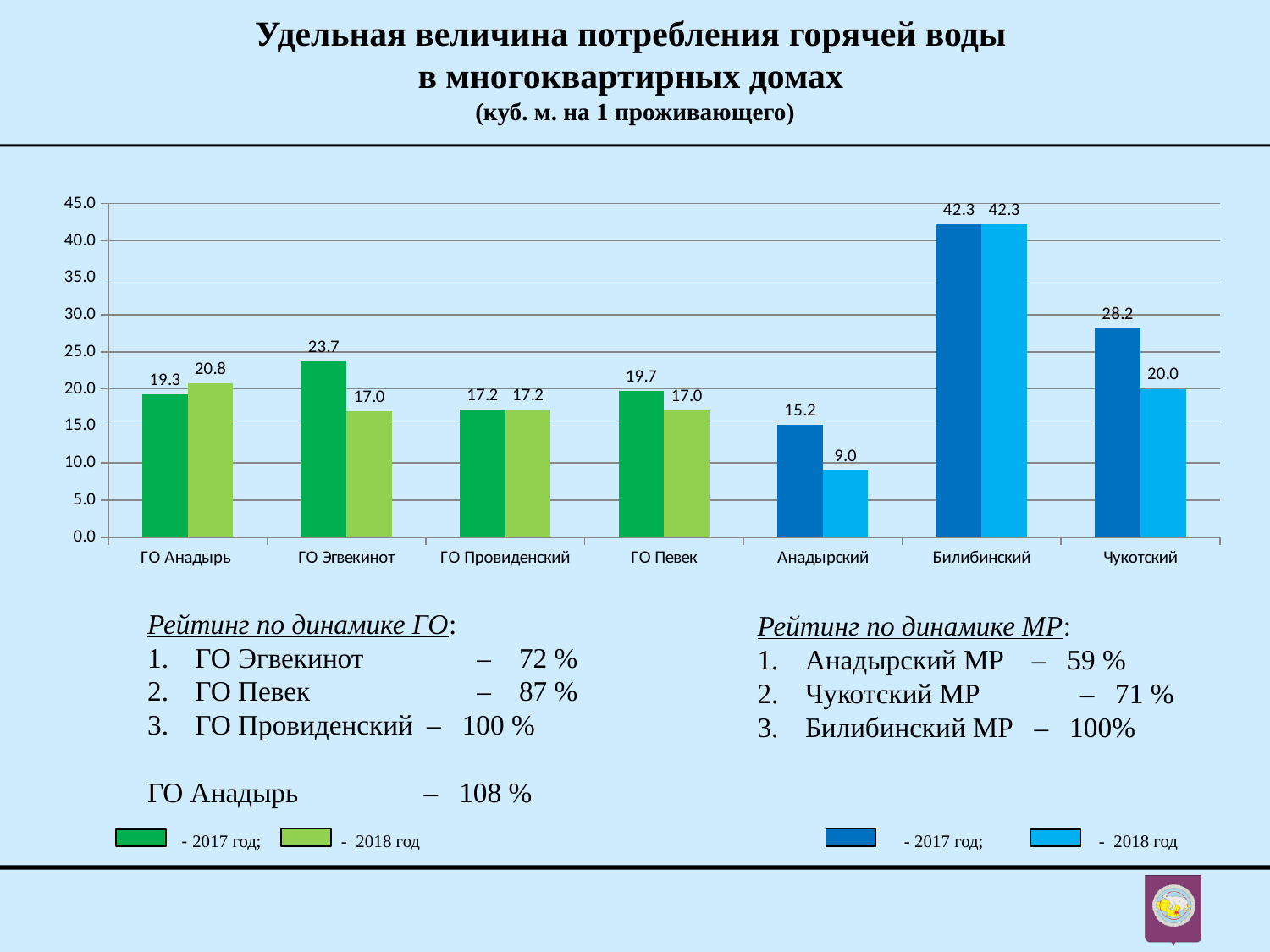
What is the 2018 value for Чукотский? 20.0 Which two years does the legend below the chart list? 2017 год and 2018 год What kind of chart is shown on the slide? bar chart Which category has the highest value in the chart? Билибинский Is the 2017 value for Билибинский greater or less than 40.0? greater What is the difference between the 2017 and 2018 values for ГО Эгвекинот? 6.7 What is the 2017 value for ГО Эгвекинот? 23.7 Which category has the lowest 2018 value? Анадырский What is the difference between the 2017 and 2018 values for Чукотский? 8.2 How many categories are shown on the x axis of the chart? 7 Which is larger for ГО Анадырь, the 2017 value or the 2018 value? 2018 What is the 2018 value for Анадырский? 9.0